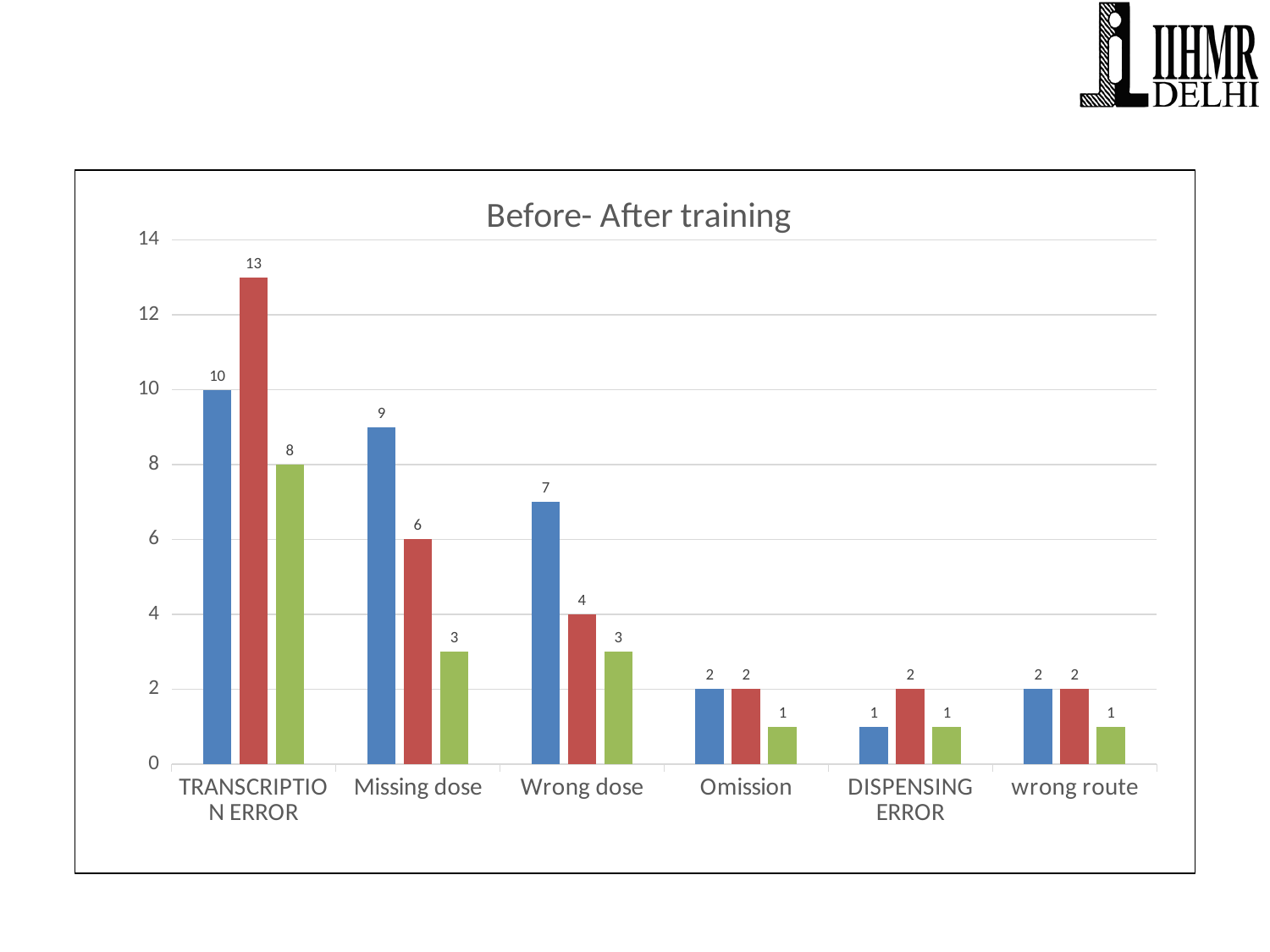
Which category has the lowest blue bar? DISPENSING ERROR What is the value of the blue bar for Missing dose? 9 How many categories are shown on the x axis of the chart? 6 Which is larger for TRANSCRIPTION ERROR, the blue bar or the red bar? The red bar What is the difference between the blue bar and the green bar for Missing dose? 6 What is the value of the red bar for TRANSCRIPTION ERROR? 13 Which category has the highest blue bar? TRANSCRIPTION ERROR What is the title of the chart? Before- After training Do the blue bar values generally rise or fall from TRANSCRIPTION ERROR to DISPENSING ERROR along the x axis? Fall What is the value of the green bar for Wrong dose? 3 How many bars are plotted for each category in the chart? 3 What type of chart is shown on the slide? Bar chart